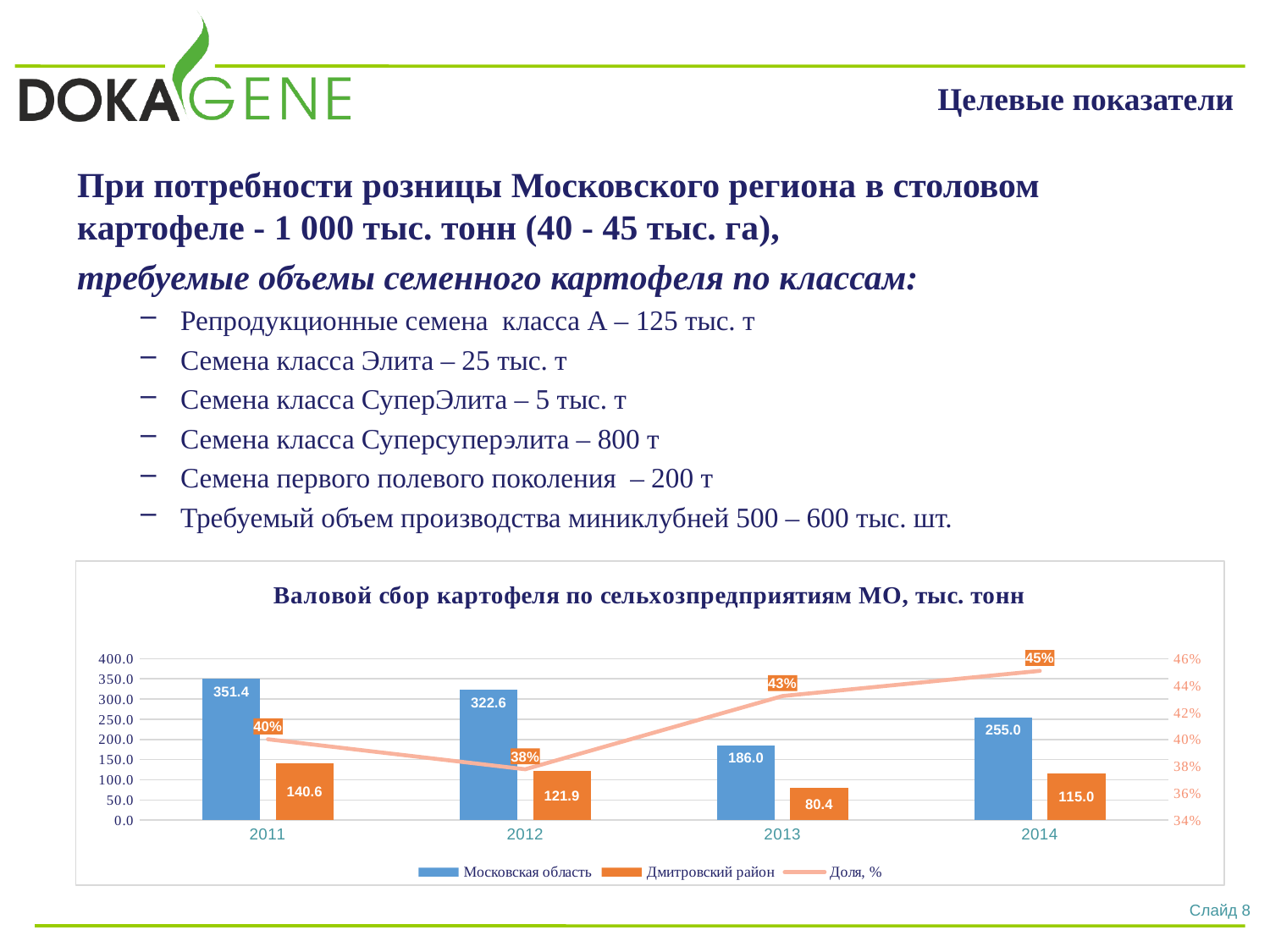
How many series does the legend list? 3 In which year is the value for Московская область the lowest? 2013 What is the difference between the Московская область values in 2011 and 2012? 28.8 Does the Доля, % line rise or fall from 2012 to 2014? rise In which year is the value for Дмитровский район the highest? 2011 What is the value of Доля, % in 2014? 45% What is the value for Московская область in 2011? 351.4 Which is larger: the Дмитровский район value in 2012 or in 2014? 2012 What is the title of the chart? Валовой сбор картофеля по сельхозпредприятиям МО, тыс. тонн How many years are shown on the x axis? 4 What kind of chart is used for the Московская область and Дмитровский район series? bar chart What is the value for Дмитровский район in 2013? 80.4